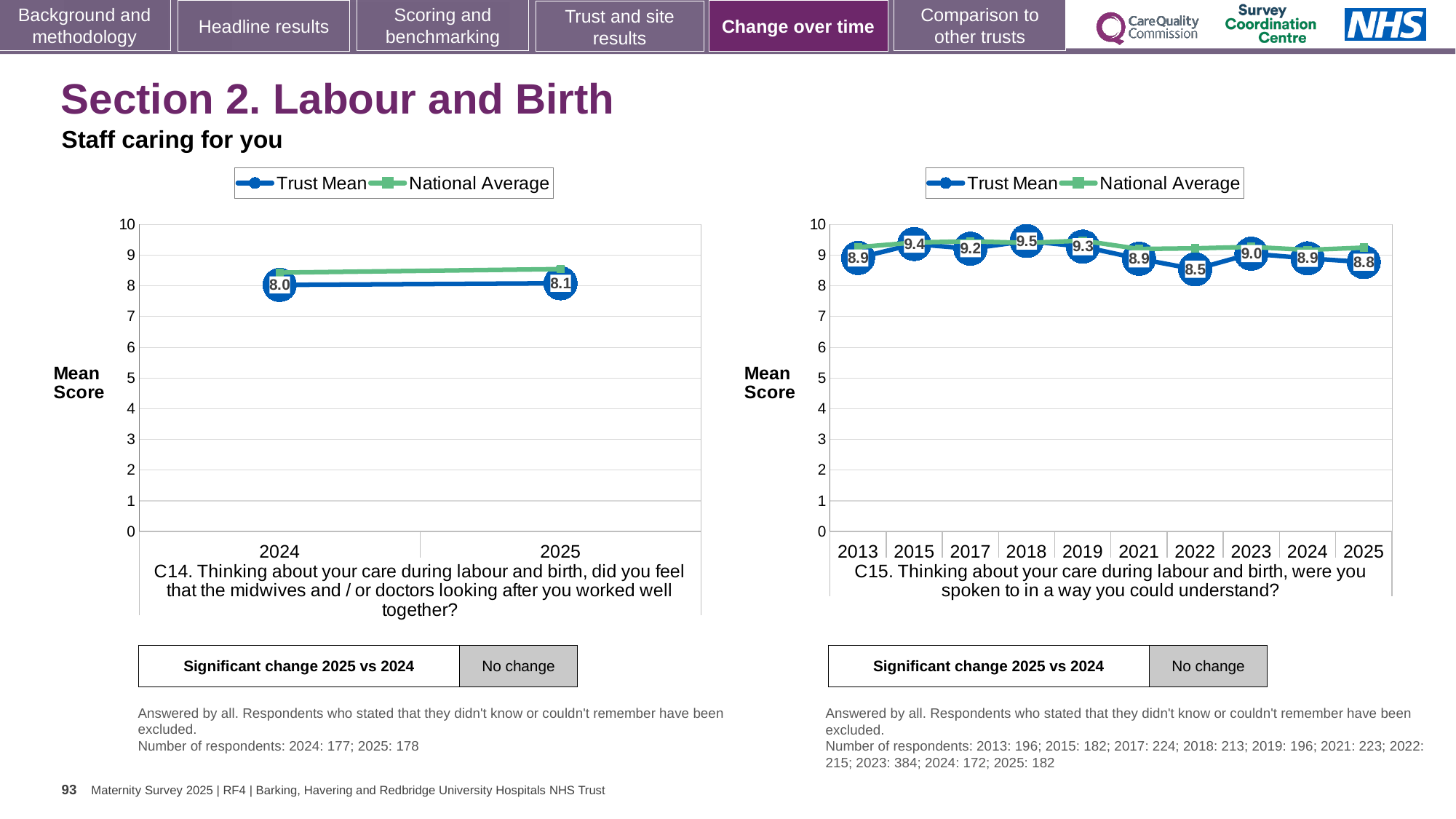
In the C15 chart on the right, what is the Trust Mean for 2022? 8.5 In the C15 chart on the right, what is the difference between the Trust Mean in 2018 and in 2022? 1.0 In the C15 chart on the right, which year has the highest Trust Mean? 2018 How many years are plotted on the x axis of the C15 chart on the right? 10 In the C15 chart on the right, does the Trust Mean rise or fall from 2023 to 2025? Fall What kind of chart is the C15 chart on the right? Line chart How many series does the legend of the C14 chart on the left list? 2 In the C14 chart on the left, what is the Trust Mean for 2025? 8.1 In the C14 chart on the left, is the National Average for 2025 greater or less than 8? greater In the C14 chart on the left, what is the Trust Mean for 2024? 8.0 In the C15 chart on the right, which year has the lowest Trust Mean? 2022 In the C15 chart on the right, is the Trust Mean higher in 2015 or in 2021? 2015